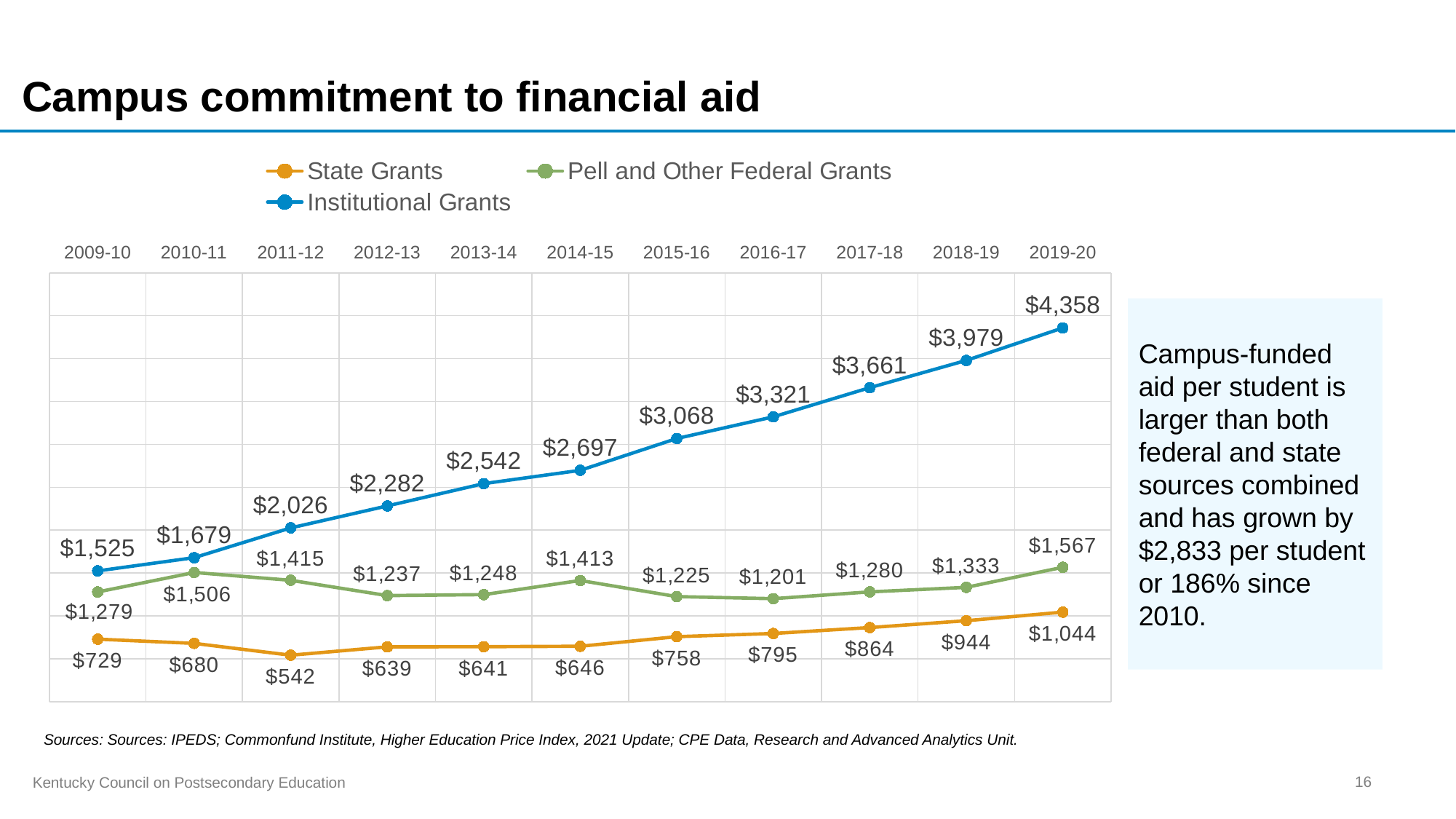
In which year is the State Grants value lowest? 2011-12 What is the value for Institutional Grants in 2019-20? $4,358 What is the difference between the Institutional Grants value in 2019-20 and in 2009-10? $2,833 In which year is the Pell and Other Federal Grants value lowest? 2016-17 How many series does the legend list? 3 What is the value for State Grants in 2011-12? $542 In which year is the Pell and Other Federal Grants value highest? 2019-20 Which is larger in 2010-11: Pell and Other Federal Grants or State Grants? Pell and Other Federal Grants Do the Institutional Grants values rise or fall from 2009-10 to 2019-20? Rise How many academic years are shown on the x axis? 11 What kind of chart is shown on the slide? Line chart What is the value for Pell and Other Federal Grants in 2014-15? $1,413